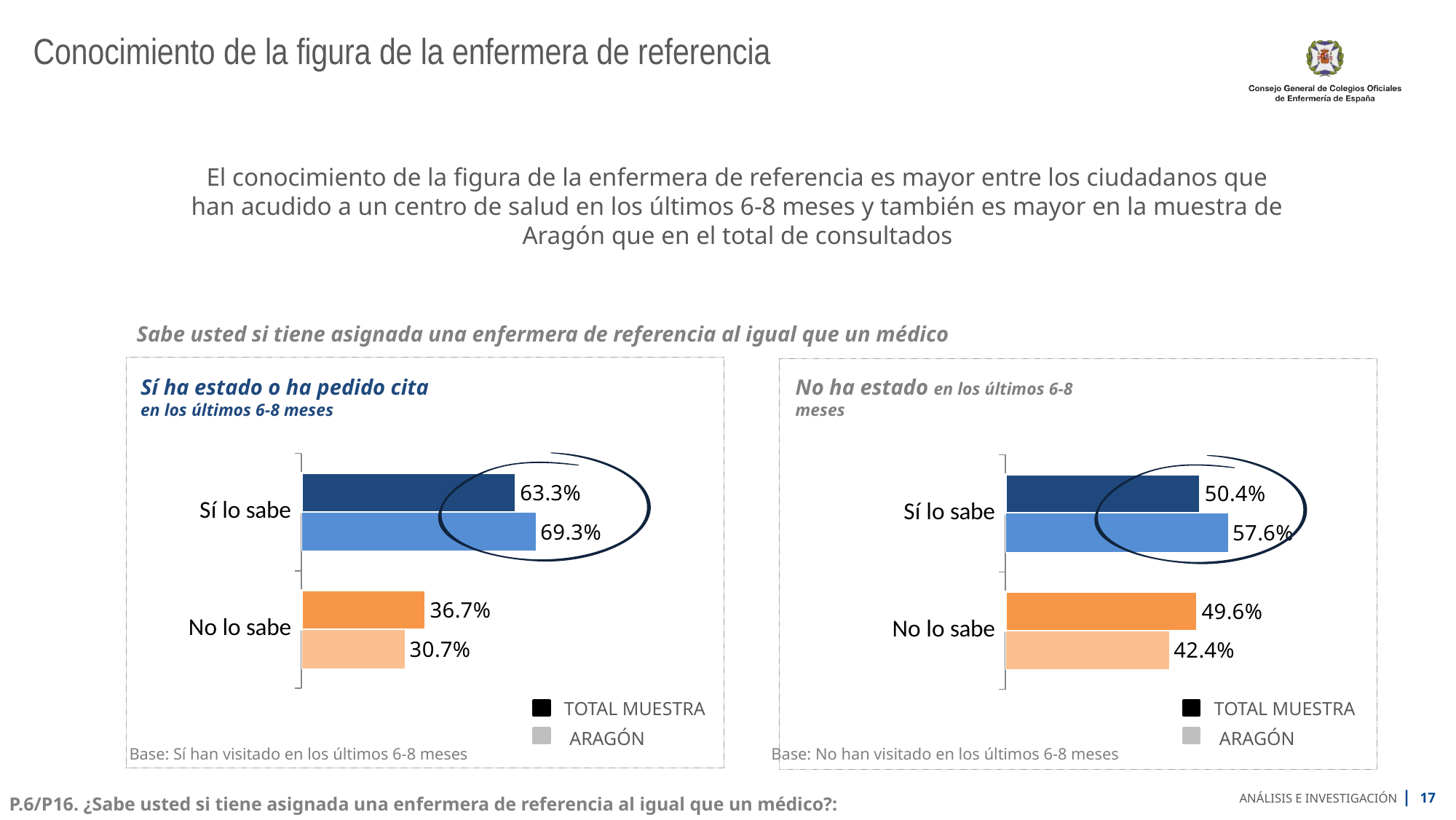
In the right chart (No ha estado en los últimos 6-8 meses), which is larger for TOTAL MUESTRA: Sí lo sabe or No lo sabe? Sí lo sabe In the left chart (Sí ha estado o ha pedido cita), what is the value for Sí lo sabe in the ARAGÓN series? 69.3% In the right chart (No ha estado en los últimos 6-8 meses), what is the value for No lo sabe in the TOTAL MUESTRA series? 49.6% What are the two legend entries in the right chart (No ha estado en los últimos 6-8 meses)? TOTAL MUESTRA and ARAGÓN In the left chart (Sí ha estado o ha pedido cita), which series has the lower value for No lo sabe? ARAGÓN How many series does the legend of the left chart list? 2 In the left chart (Sí ha estado o ha pedido cita), what is the difference between the ARAGÓN and TOTAL MUESTRA values for Sí lo sabe? 6.0% In the right chart (No ha estado en los últimos 6-8 meses), what is the value for Sí lo sabe in the ARAGÓN series? 57.6% In the left chart (Sí ha estado o ha pedido cita), what is the value for Sí lo sabe in the TOTAL MUESTRA series? 63.3% How many categories are shown in the right chart (No ha estado en los últimos 6-8 meses)? 2 In the right chart (No ha estado en los últimos 6-8 meses), what is the difference between the TOTAL MUESTRA and ARAGÓN values for No lo sabe? 7.2% What kind of chart is the left chart (Sí ha estado o ha pedido cita)? Bar chart